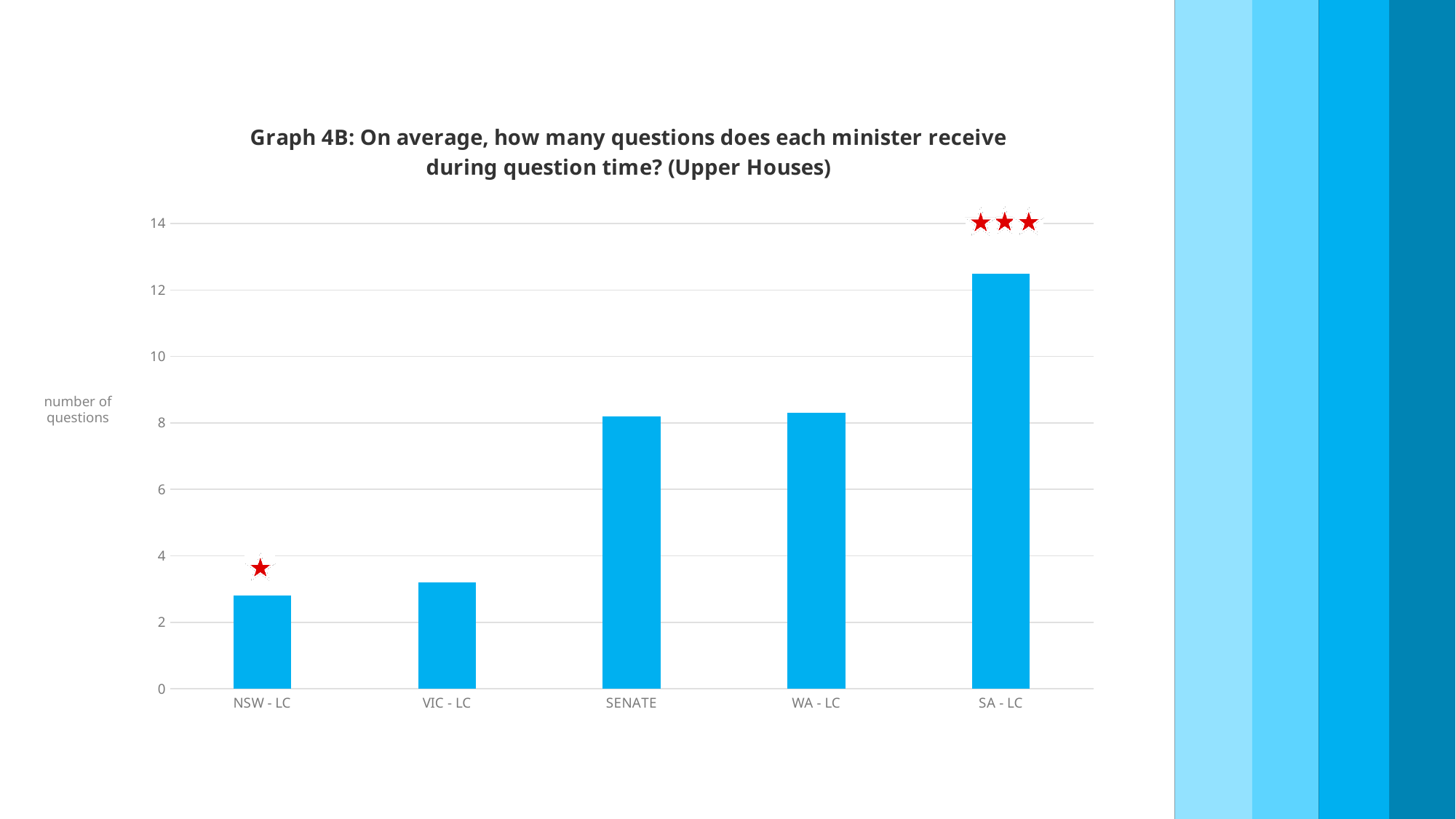
What kind of chart is shown on the slide? bar chart Is the value for NSW - LC greater or less than 4? less Which is larger, the value for SA - LC or the value for WA - LC? SA - LC What is the label on the vertical axis of the chart? number of questions Is the value for SA - LC greater or less than 12? greater Is the value for VIC - LC greater or less than 4? less Which category has the lowest bar in the chart? NSW - LC How many categories are shown on the x axis of the chart? 5 Which is larger, the value for SENATE or the value for VIC - LC? SENATE Which category has the highest bar in the chart? SA - LC Do the bar values generally rise or fall from left to right along the x axis? rise